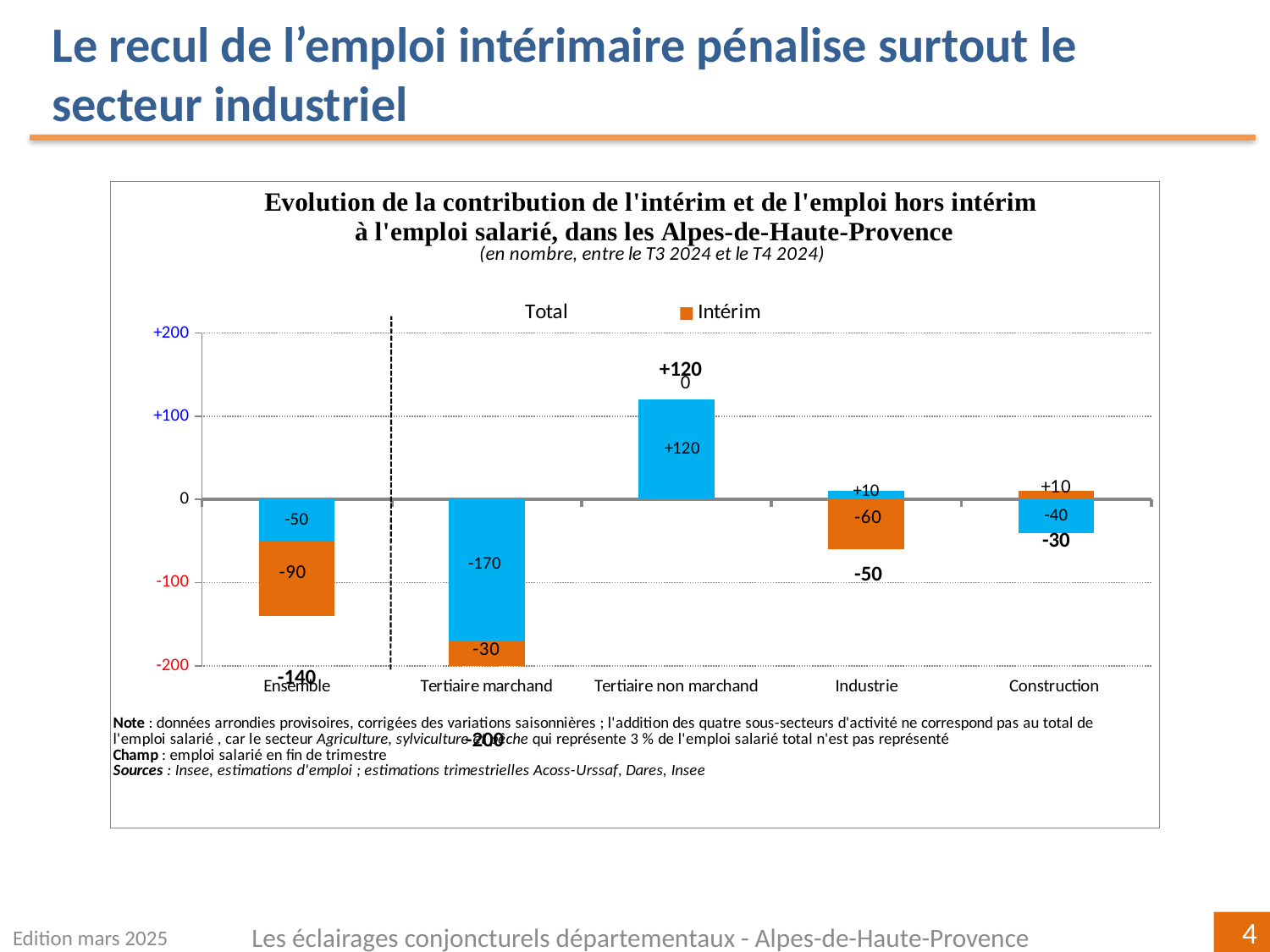
Which category has the highest total value? Tertiaire non marchand How many series does the chart legend list? 2 What is the value of the blue segment for Tertiaire non marchand? +120 What is the total value labelled for Ensemble? -140 What is the Intérim (orange) value for Tertiaire marchand? -30 What are the two entries in the chart legend? Total and Intérim Which category has the lowest total value? Tertiaire marchand What is the difference between the total for Tertiaire non marchand (+120) and the total for Industrie (-50)? 170 What kind of chart is shown on the slide? bar chart How many categories are shown on the x axis of the chart? 5 What is the Intérim (orange) value for Construction? +10 What is the Intérim (orange) value for Industrie? -60